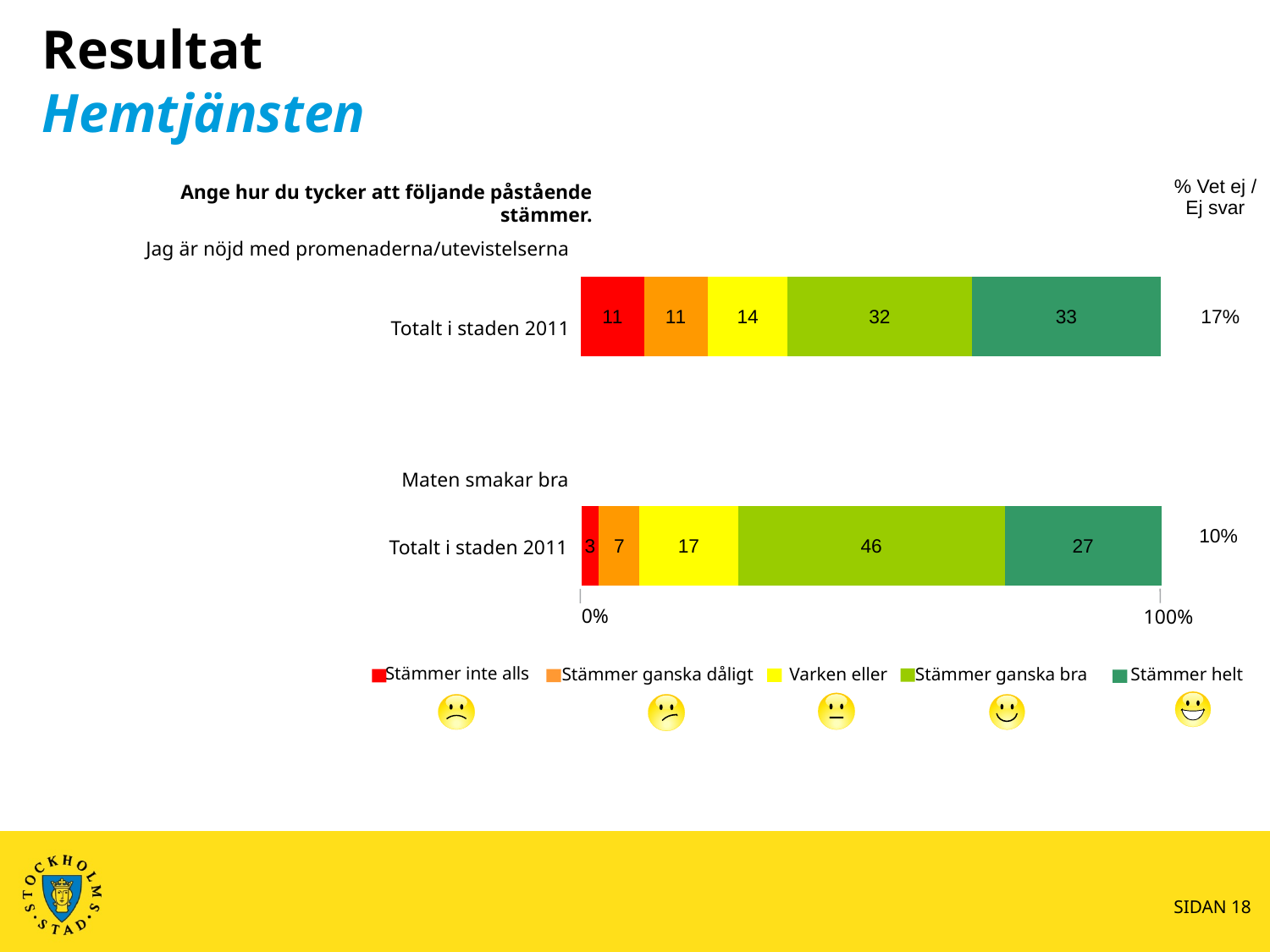
In the chart for "Maten smakar bra", what is the difference between "Stämmer ganska bra" and "Stämmer helt"? 19 In the chart for "Jag är nöjd med promenaderna/utevistelserna", which response category has the smallest segment? Stämmer inte alls and Stämmer ganska dåligt (tied at 11) What kind of chart is used on this slide? Stacked bar chart In the chart for "Jag är nöjd med promenaderna/utevistelserna", what is the value for "Stämmer helt" for Totalt i staden 2011? 33 Is the "Stämmer helt" value larger in the chart for "Jag är nöjd med promenaderna/utevistelserna" or in the chart for "Maten smakar bra"? Jag är nöjd med promenaderna/utevistelserna In the chart for "Jag är nöjd med promenaderna/utevistelserna", what is the difference between "Stämmer ganska bra" and "Varken eller"? 18 In the chart for "Jag är nöjd med promenaderna/utevistelserna", what is the "% Vet ej / Ej svar" value shown to the right of the bar? 17% In the chart for "Maten smakar bra", what is the value for "Stämmer inte alls"? 3 In the chart for "Maten smakar bra", what is the value for "Stämmer ganska bra" for Totalt i staden 2011? 46 How many response categories does the legend list? 5 In the chart for "Maten smakar bra", which response category has the smallest segment? Stämmer inte alls In the chart for "Maten smakar bra", which response category has the largest segment? Stämmer ganska bra